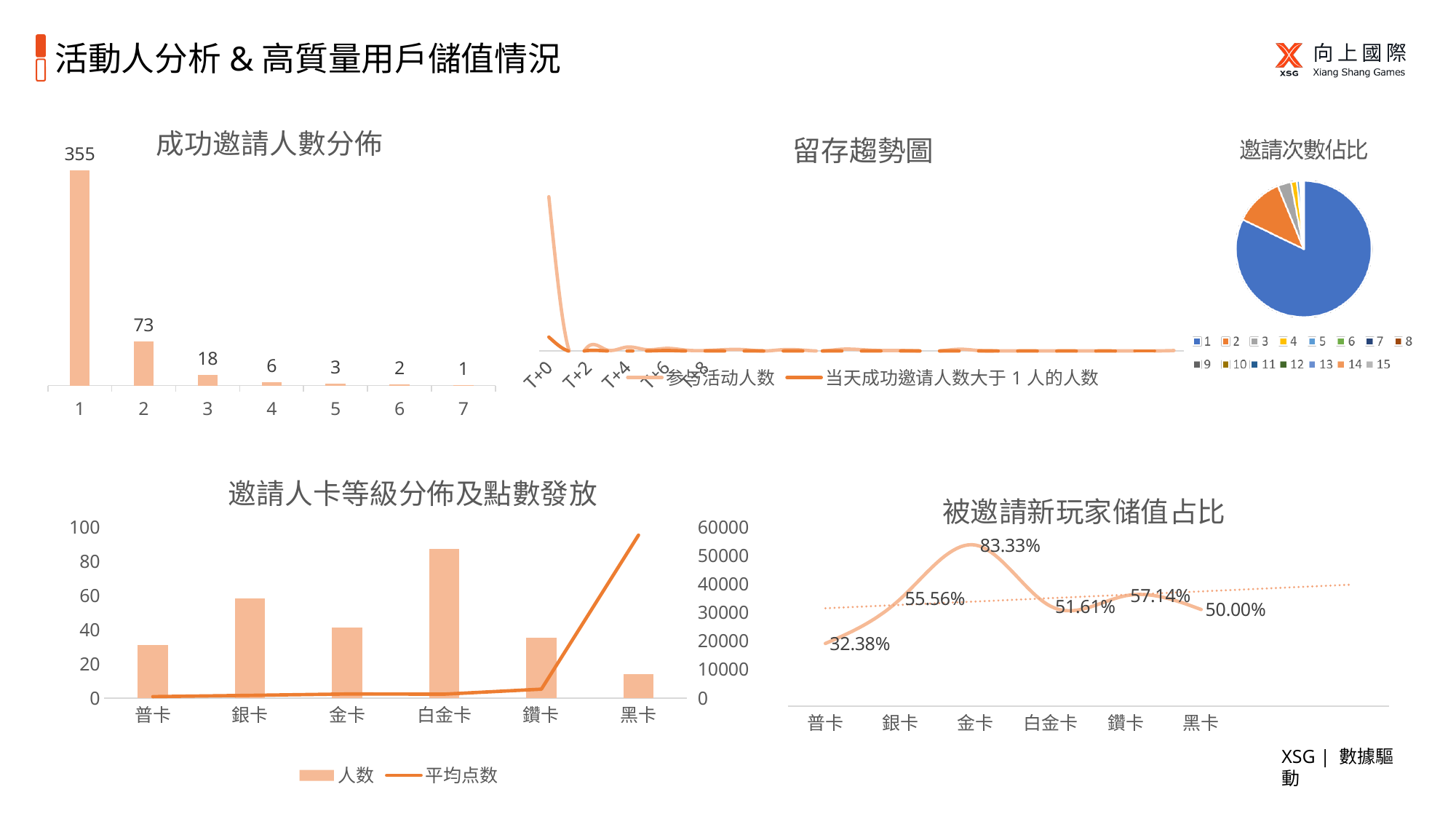
In the 成功邀請人數分佈 chart, what is the value for category 3? 18 In the 成功邀請人數分佈 chart, what is the value for category 1? 355 In the 邀請人卡等級分佈及點數發放 chart, which category has the tallest 人数 bar? 白金卡 In the 成功邀請人數分佈 chart, what is the difference between the values for categories 1 and 2? 282 How many categories are shown in the 成功邀請人數分佈 chart? 7 In the 被邀請新玩家儲值占比 chart, which category has the lowest value? 普卡 In the 被邀請新玩家儲值占比 chart, what is the value for 金卡? 83.33% What kind of chart is 邀請次數佔比? pie chart In the 邀請人卡等級分佈及點數發放 chart, is the 人数 value for 白金卡 greater or less than 80? greater How many series does the legend of the 留存趨勢圖 chart list? 2 What kind of chart is 成功邀請人數分佈? bar chart In the 邀請次數佔比 pie chart, which legend category has the largest slice? 1